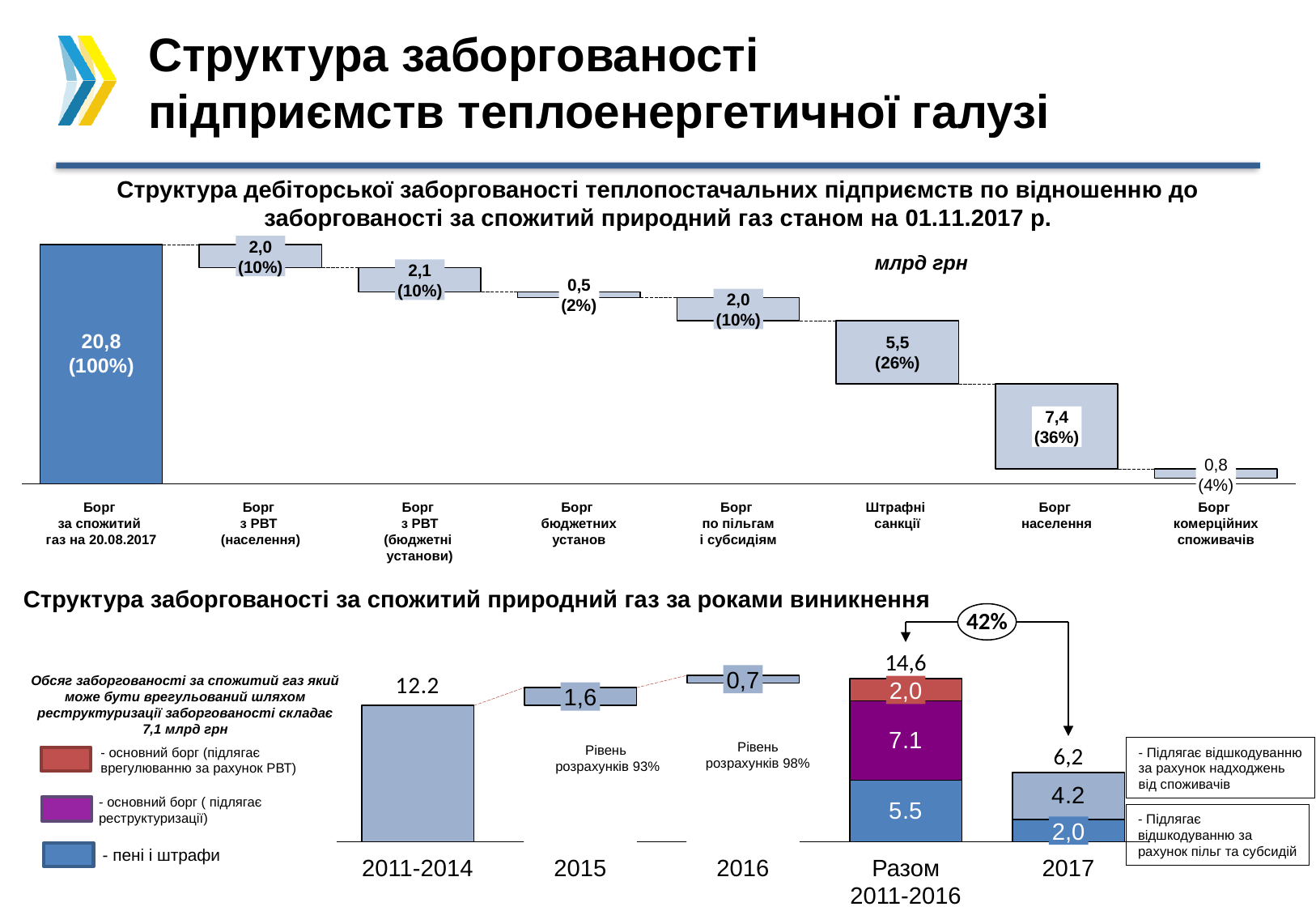
In the bottom chart, what is the total of the stacked bar for Разом 2011-2016? 14,6 What kind of chart is the bottom chart? Bar chart In the top chart, what is the difference between Борг населення and Штрафні санкції? 1,9 In the top chart, which is larger: Борг з РВТ (населення) or Борг з РВТ (бюджетні установи)? Борг з РВТ (бюджетні установи) In the top chart, what is the value for Борг населення? 7,4 In the bottom chart, what is the value of пені і штрафи in the Разом 2011-2016 bar? 5.5 In the bottom chart, what is the value for 2011-2014? 12.2 How many series does the legend of the bottom chart list? 3 In the top chart, which debt component (excluding the total Борг за спожитий газ) has the highest value? Борг населення In the top chart, which debt component has the lowest value? Борг бюджетних установ How many categories are shown along the x axis of the top chart? 8 In the top chart, what percentage share is shown for Штрафні санкції? 26%